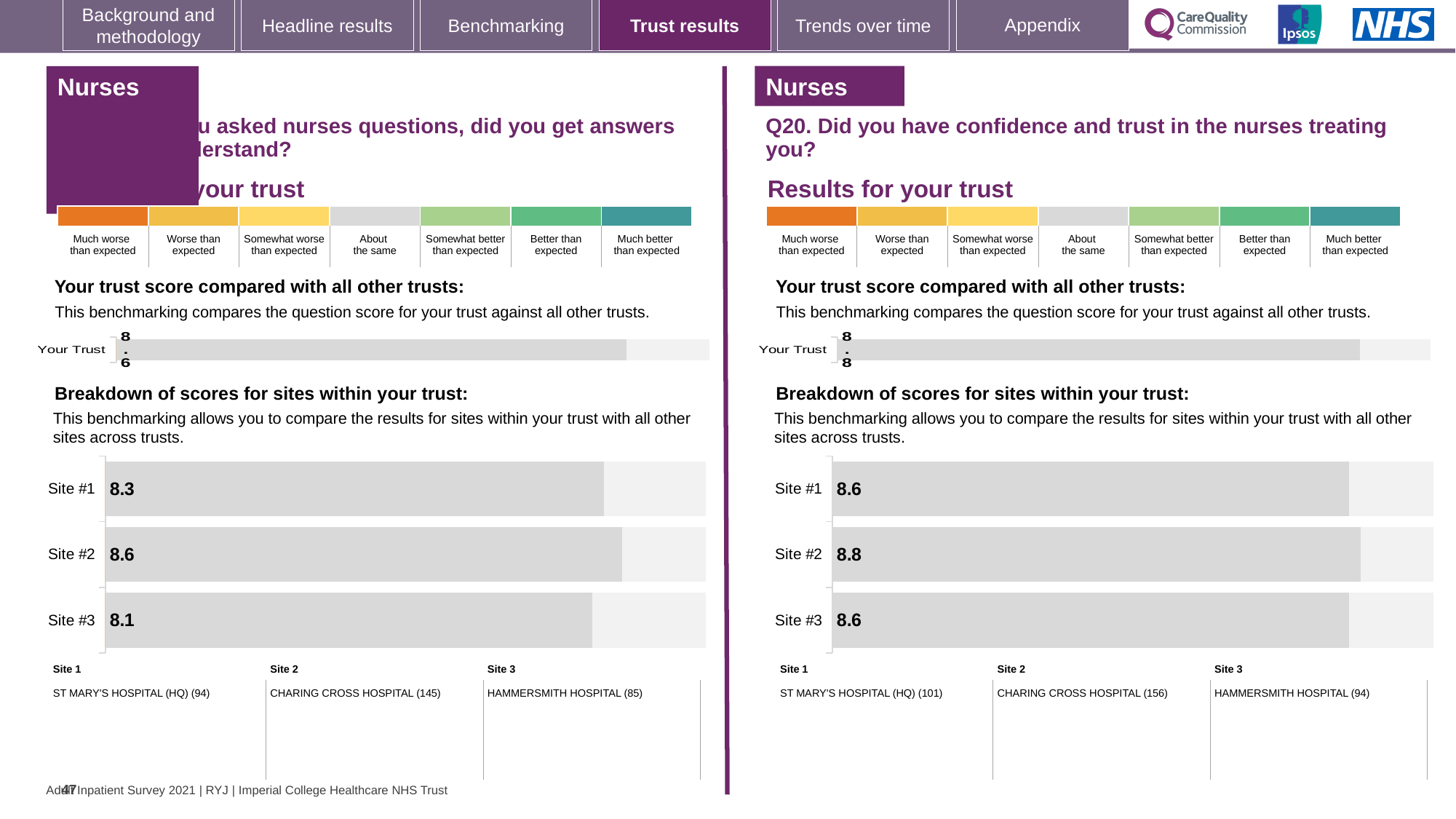
On the Q20 (confidence and trust in nurses) site breakdown chart, what is the score for Site #2? 8.8 On the left-hand site breakdown chart, what is the score for Site #3? 8.1 On the Q20 (confidence and trust in nurses) site breakdown chart, how many sites are shown? 3 On the Q20 (confidence and trust in nurses) site breakdown chart, which site has the highest score? Site #2 What type of chart is used for the site breakdown on the Q20 (confidence and trust in nurses) panel? Bar chart On the left-hand site breakdown chart, which site has the highest score? Site #2 On the Q20 (confidence and trust in nurses) 'Your trust score compared with all other trusts' chart, what is the score for Your Trust? 8.8 On the left-hand site breakdown chart, which site has the lowest score? Site #3 On the left-hand site breakdown chart, what is the difference between the scores for Site #2 and Site #3? 0.5 On the left-hand 'Your trust score compared with all other trusts' chart, what is the score for Your Trust? 8.6 On the left-hand site breakdown chart, what is the score for Site #1? 8.3 On the Q20 (confidence and trust in nurses) site breakdown chart, what is the score for Site #1? 8.6